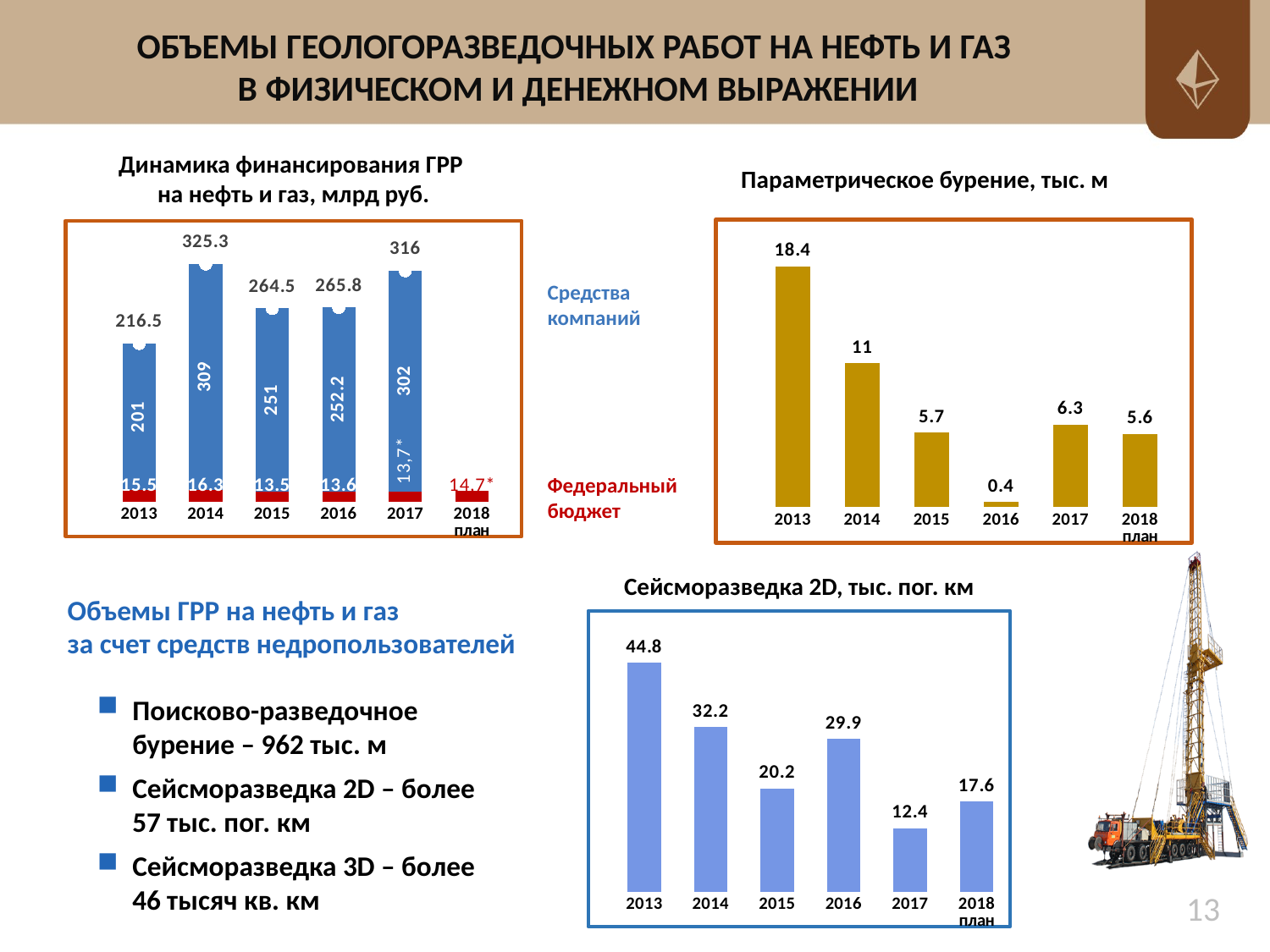
In the chart 'Сейсморазведка 2D, тыс. пог. км', how many years are shown on the x axis? 6 In the chart 'Сейсморазведка 2D, тыс. пог. км', which year has the highest value? 2013 In the chart 'Параметрическое бурение, тыс. м', what is the value for 2013? 18.4 In the chart 'Динамика финансирования ГРР на нефть и газ, млрд руб.', how many series are shown? 2 In the chart 'Параметрическое бурение, тыс. м', what is the difference between the values for 2014 and 2015? 5.3 In the chart 'Динамика финансирования ГРР на нефть и газ, млрд руб.', what is the value of Федеральный бюджет for 2013? 15.5 What kind of chart is 'Сейсморазведка 2D, тыс. пог. км'? Bar chart In the chart 'Динамика финансирования ГРР на нефть и газ, млрд руб.', what is the value of Средства компаний for 2017? 302 In the chart 'Динамика финансирования ГРР на нефть и газ, млрд руб.', what is the total for 2014? 325.3 In the chart 'Сейсморазведка 2D, тыс. пог. км', which is larger: the value for 2015 or the value for 2018 план? 2015 In the chart 'Сейсморазведка 2D, тыс. пог. км', what is the value for 2016? 29.9 In the chart 'Параметрическое бурение, тыс. м', which year has the lowest value? 2016